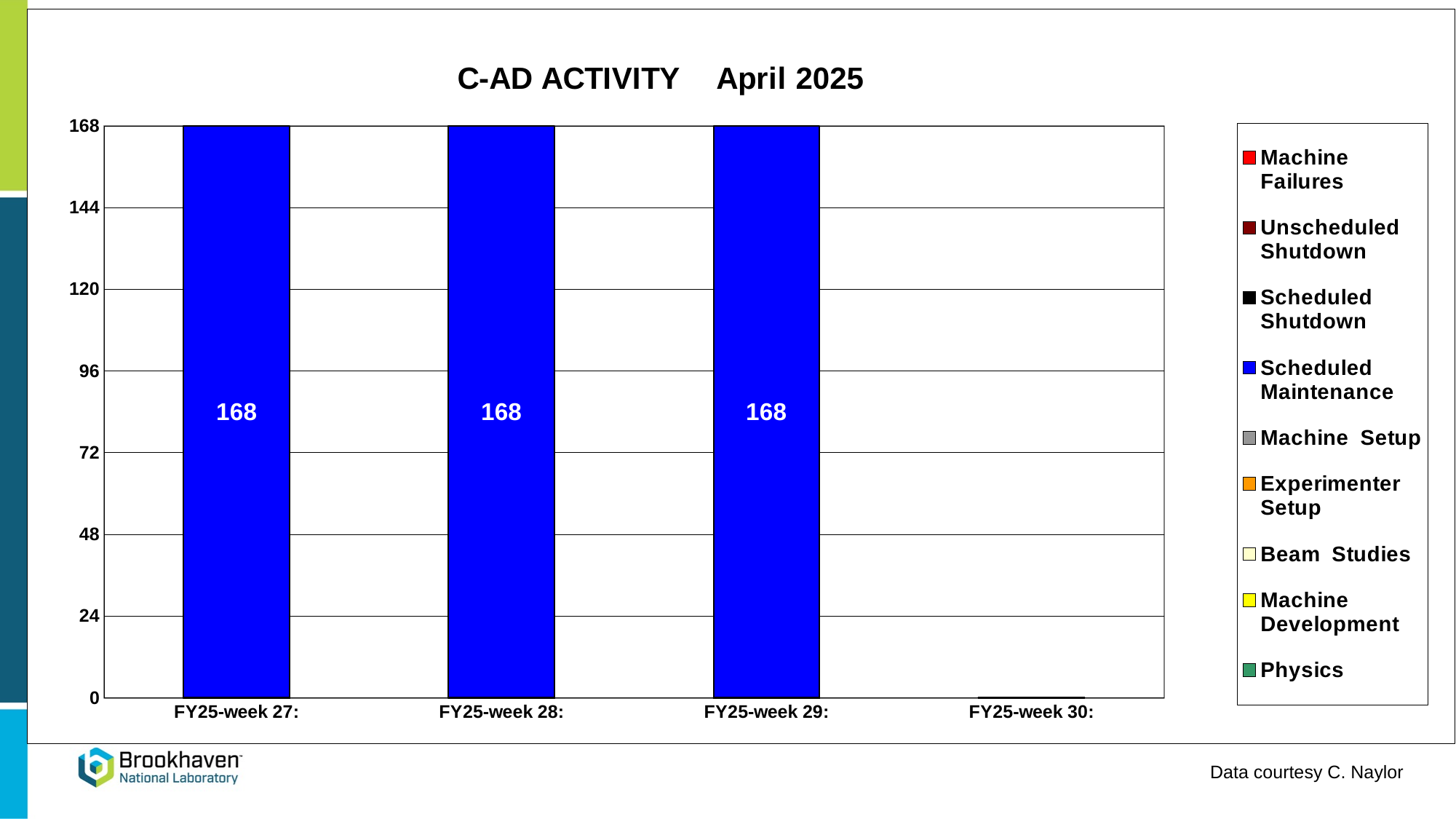
What is the value of Scheduled Maintenance for FY25-week 27? 168 Is the value for FY25-week 30 greater or less than 24? less What is the value of Scheduled Maintenance for FY25-week 29? 168 How many categories are shown on the x axis? 4 What is the title of the chart? C-AD ACTIVITY April 2025 What is the difference between the Scheduled Maintenance values for FY25-week 27 and FY25-week 29? 0 What is the value of Scheduled Maintenance for FY25-week 28? 168 How many series does the legend list? 9 Which category has the lowest total? FY25-week 30: Which legend entry is shown in blue? Scheduled Maintenance What kind of chart is shown on the slide? bar chart Is the value for FY25-week 28 greater or less than 144? greater